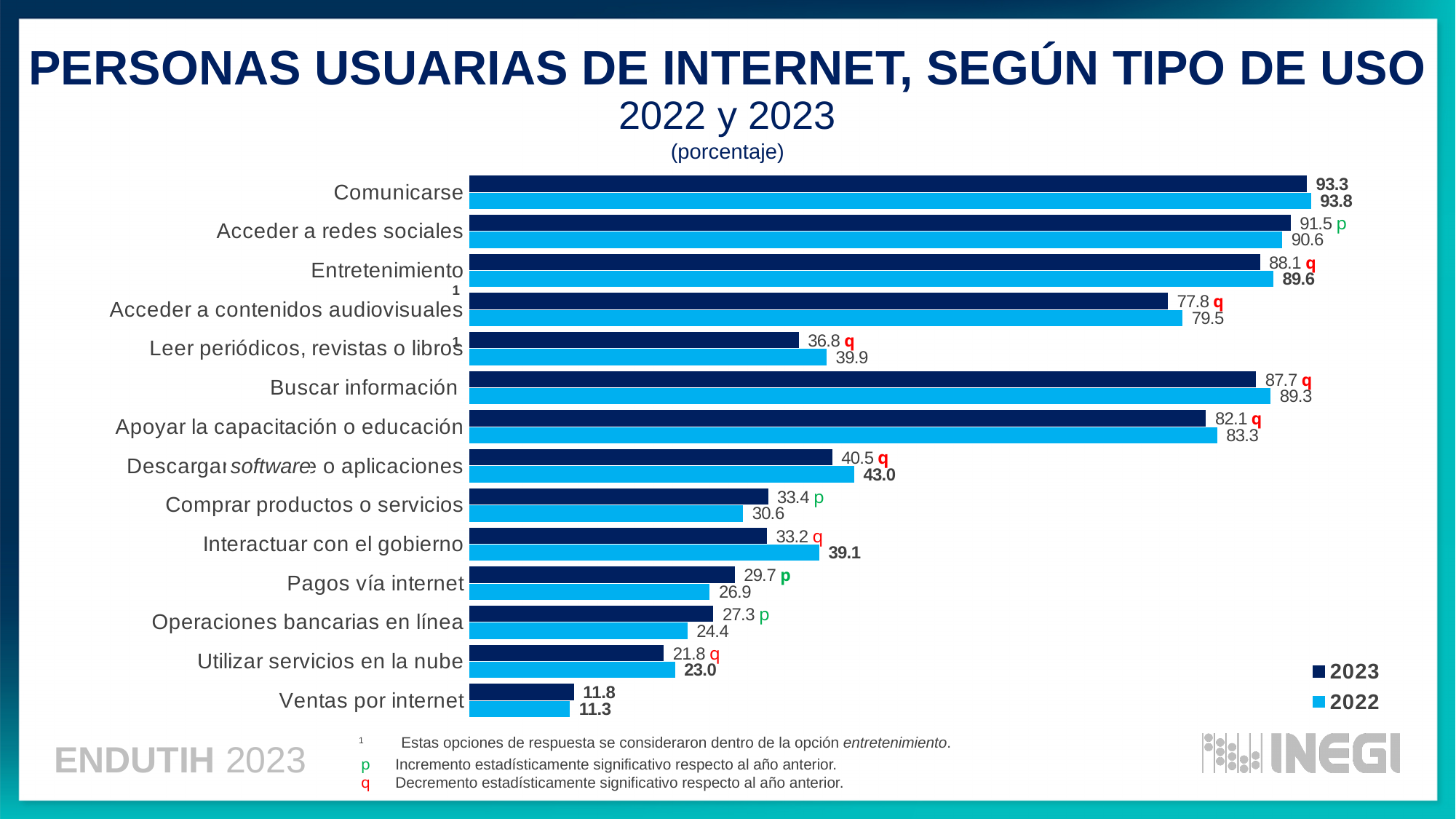
What is the 2023 value for Pagos vía internet? 29.7 How many categories (types of use) are shown in the chart? 14 What kind of chart is shown on the slide? Bar chart What is the 2022 value for Descargar software o aplicaciones? 43.0 What is the 2022 value for Interactuar con el gobierno? 39.1 What is the difference between the 2022 and 2023 values for Interactuar con el gobierno? 5.9 Which category has the lowest 2023 value? Ventas por internet How many series does the legend list? 2 What is the 2023 value for Comunicarse? 93.3 For Leer periódicos, revistas o libros, which year has the larger value, 2022 or 2023? 2022 What is the difference between the 2023 and 2022 values for Comprar productos o servicios? 2.8 Which category has the highest 2022 value? Comunicarse